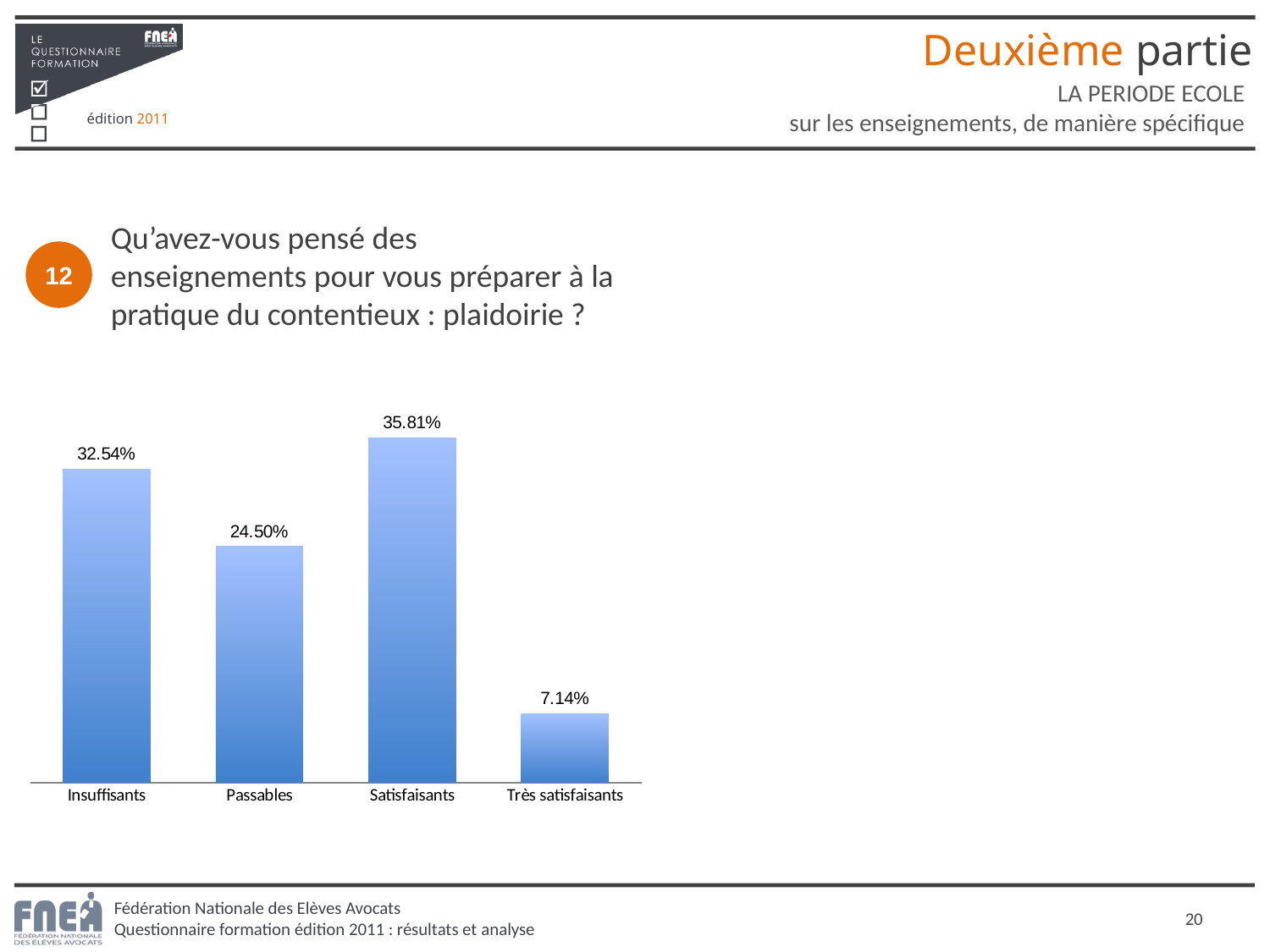
What is the difference between the values for Passables and Très satisfaisants? 17.36% Which category has the highest value? Satisfaisants What is the value for Passables? 24.50% What is the difference between the values for Satisfaisants and Insuffisants? 3.27% What is the value for Très satisfaisants? 7.14% What kind of chart is shown on the slide? Bar chart How many categories are shown in the chart? 4 Which is larger, the value for Insuffisants or the value for Passables? Insuffisants What is the value for Satisfaisants? 35.81% Which category has the lowest value? Très satisfaisants What is the number shown in the orange circle next to the question text? 12 What is the value for Insuffisants? 32.54%